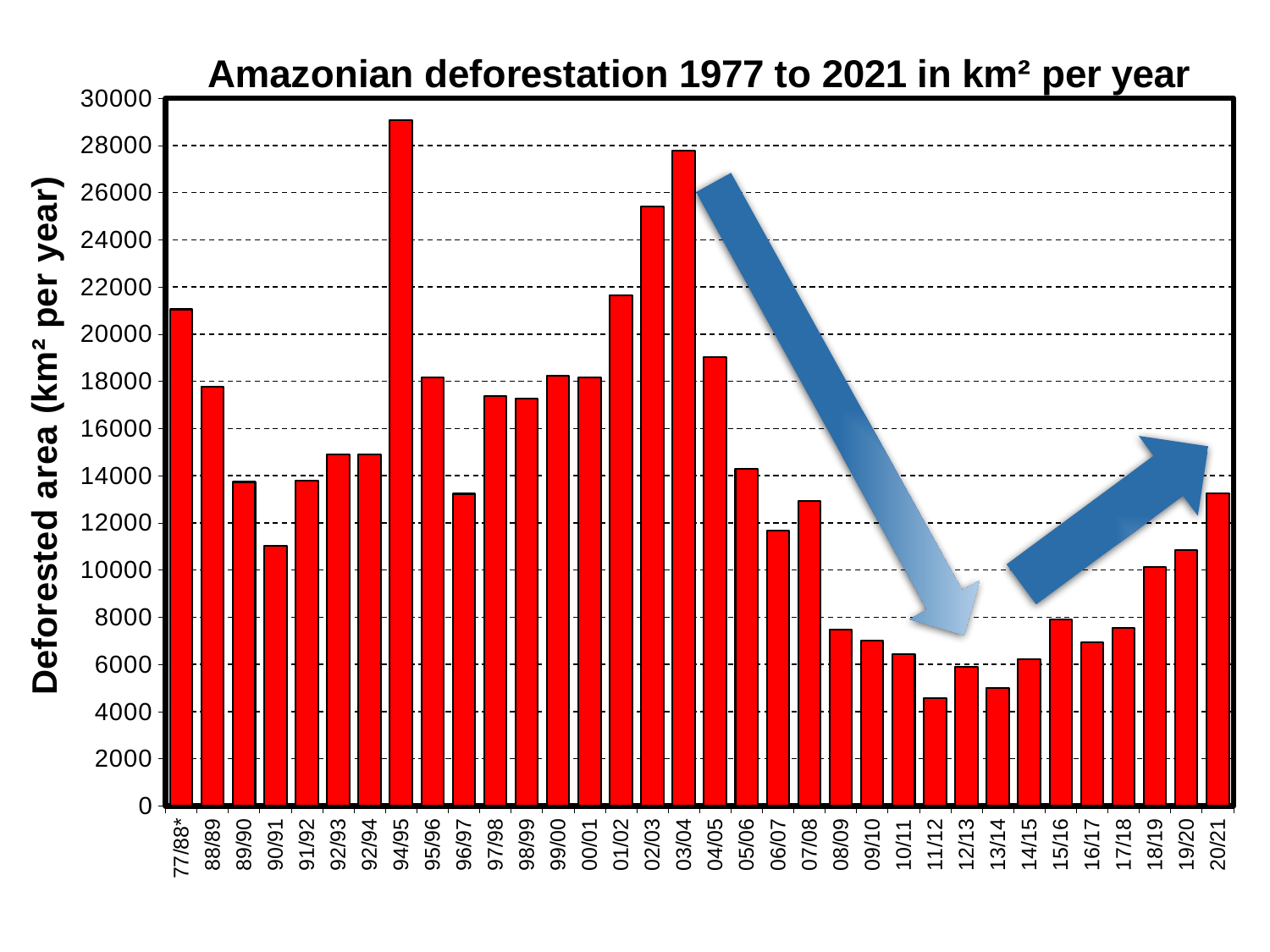
How many year categories are shown on the x axis? 34 What is the title of the chart? Amazonian deforestation 1977 to 2021 in km² per year Is the value for 11/12 greater or less than 6000? less Is the value for 94/95 greater or less than 28000? greater Is the value for 20/21 greater or less than 12000? greater Which year has the highest deforested area? 94/95 Which is larger, the value for 02/03 or the value for 04/05? 02/03 What kind of chart is shown on the slide? bar chart What is the label on the vertical axis? Deforested area (km² per year) Which year has the lowest deforested area? 11/12 Do the values rise or fall from 03/04 to 11/12? fall